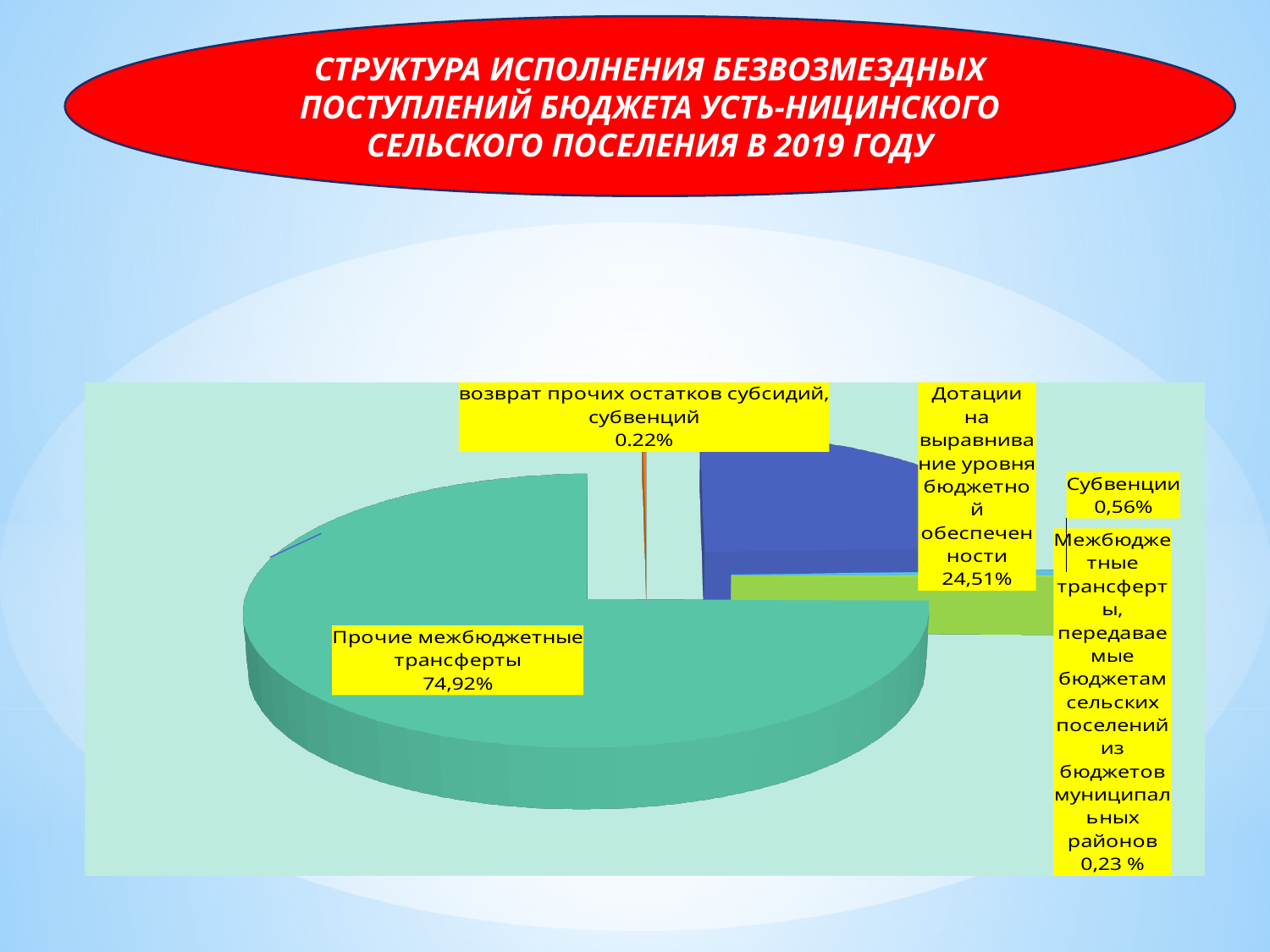
Which category has the smallest share of the pie? возврат прочих остатков субсидий, субвенций How many slices (categories) does the pie chart have? 5 What is the difference in percentage points between "Прочие межбюджетные трансферты" and "Дотации на выравнивание уровня бюджетной обеспеченности"? 50,41 What share is shown for "Дотации на выравнивание уровня бюджетной обеспеченности"? 24,51% What share is shown for "Межбюджетные трансферты, передаваемые бюджетам сельских поселений из бюджетов муниципальных районов"? 0,23 % What kind of chart is shown on the slide? Pie chart What share is shown for "Субвенции"? 0,56% Which year does the chart title say the data refers to? 2019 Which is larger: the share for "Субвенции" or the share for "Дотации на выравнивание уровня бюджетной обеспеченности"? Дотации на выравнивание уровня бюджетной обеспеченности Which category has the largest share of the pie? Прочие межбюджетные трансферты What share is shown for "возврат прочих остатков субсидий, субвенций"? 0.22% What share of the pie is labelled for "Прочие межбюджетные трансферты"? 74,92%